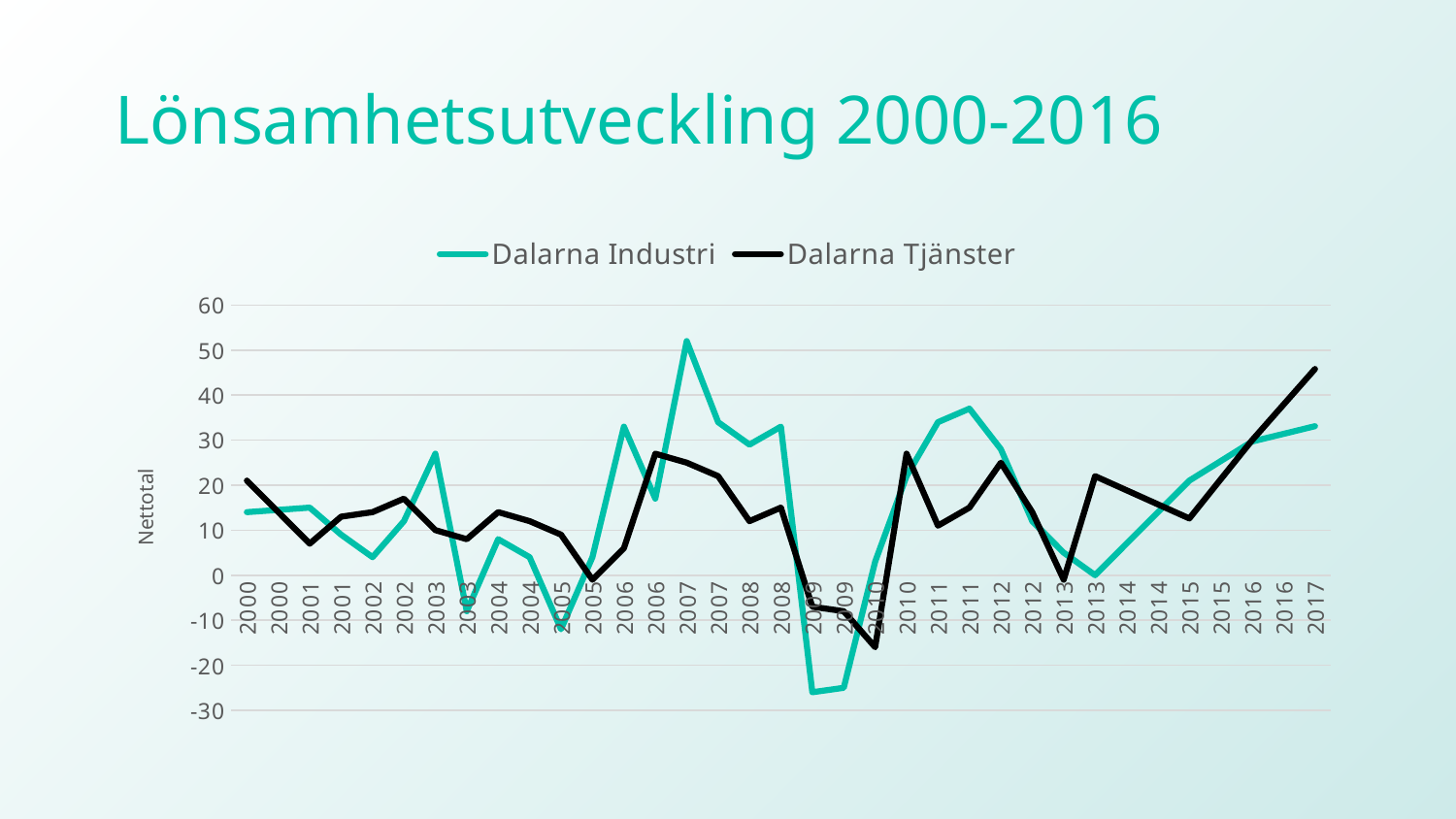
At the 2007 peak, which series has the higher value, Dalarna Industri or Dalarna Tjänster? Dalarna Industri Which series is drawn in black? Dalarna Tjänster Which series reaches the lowest value anywhere on the chart? Dalarna Industri What is the label on the vertical axis? Nettotal At 2017, which series has the higher value, Dalarna Industri or Dalarna Tjänster? Dalarna Tjänster Is the lowest value for Dalarna Industri (around 2009) greater or less than -20? less How many series does the legend list? 2 What kind of chart is shown on the slide? Line chart Is the highest value for Dalarna Industri (at 2007) greater or less than 40? greater Is the value for Dalarna Tjänster at 2017 greater or less than 40? greater Which series reaches the highest value anywhere on the chart? Dalarna Industri What is the title of the chart? Lönsamhetsutveckling 2000-2016